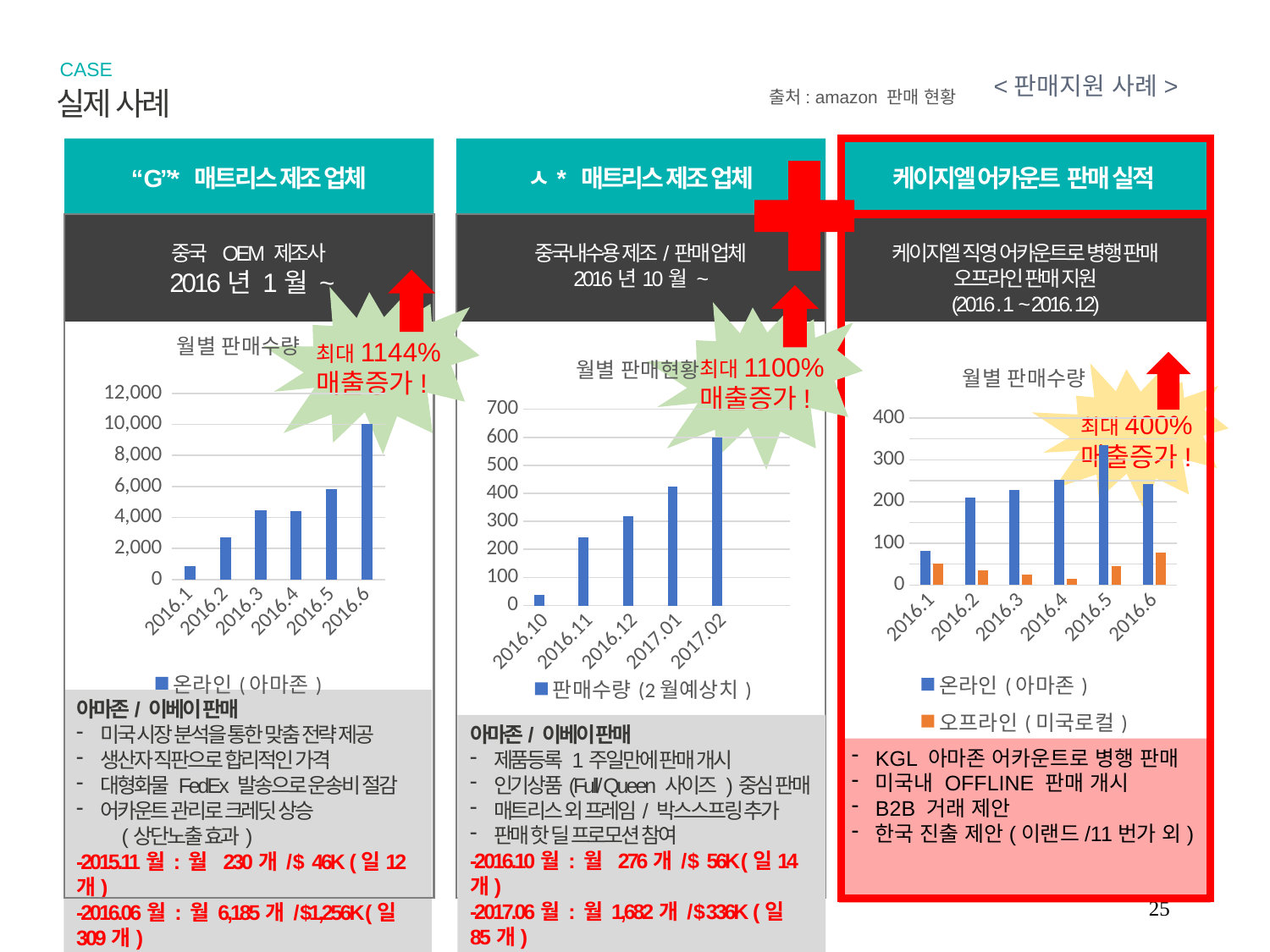
In the left chart (월별 판매수량 under "G"* 매트리스 제조 업체), how many months are plotted on the x axis? 6 In the right chart (월별 판매수량 under 케이지엘 어카운트 판매 실적), for 2016.6, which is larger: 온라인 (아마존) or 오프라인 (미국로컬)? 온라인 (아마존) In the middle chart (월별 판매현황 under ㅅ* 매트리스 제조 업체), do the values rise or fall from 2016.10 to 2017.02? rise In the middle chart (월별 판매현황 under ㅅ* 매트리스 제조 업체), is the value for 2016.10 greater or less than 100? less In the left chart (월별 판매수량 under "G"* 매트리스 제조 업체), is the value for 2016.6 greater or less than 8,000? greater In the right chart (월별 판매수량 under 케이지엘 어카운트 판매 실적), which month has the highest 온라인 (아마존) value? 2016.5 In the middle chart (월별 판매현황 under ㅅ* 매트리스 제조 업체), how many months are plotted? 5 In the middle chart (월별 판매현황 under ㅅ* 매트리스 제조 업체), which month has the highest value? 2017.02 In the left chart (월별 판매수량 under "G"* 매트리스 제조 업체), which month has the highest value? 2016.6 How many series does the legend of the right chart (월별 판매수량 under 케이지엘 어카운트 판매 실적) list? 2 In the left chart (월별 판매수량 under "G"* 매트리스 제조 업체), which month has the lowest value? 2016.1 What kind of chart is the left chart titled 월별 판매수량 (under "G"* 매트리스 제조 업체)? Bar chart